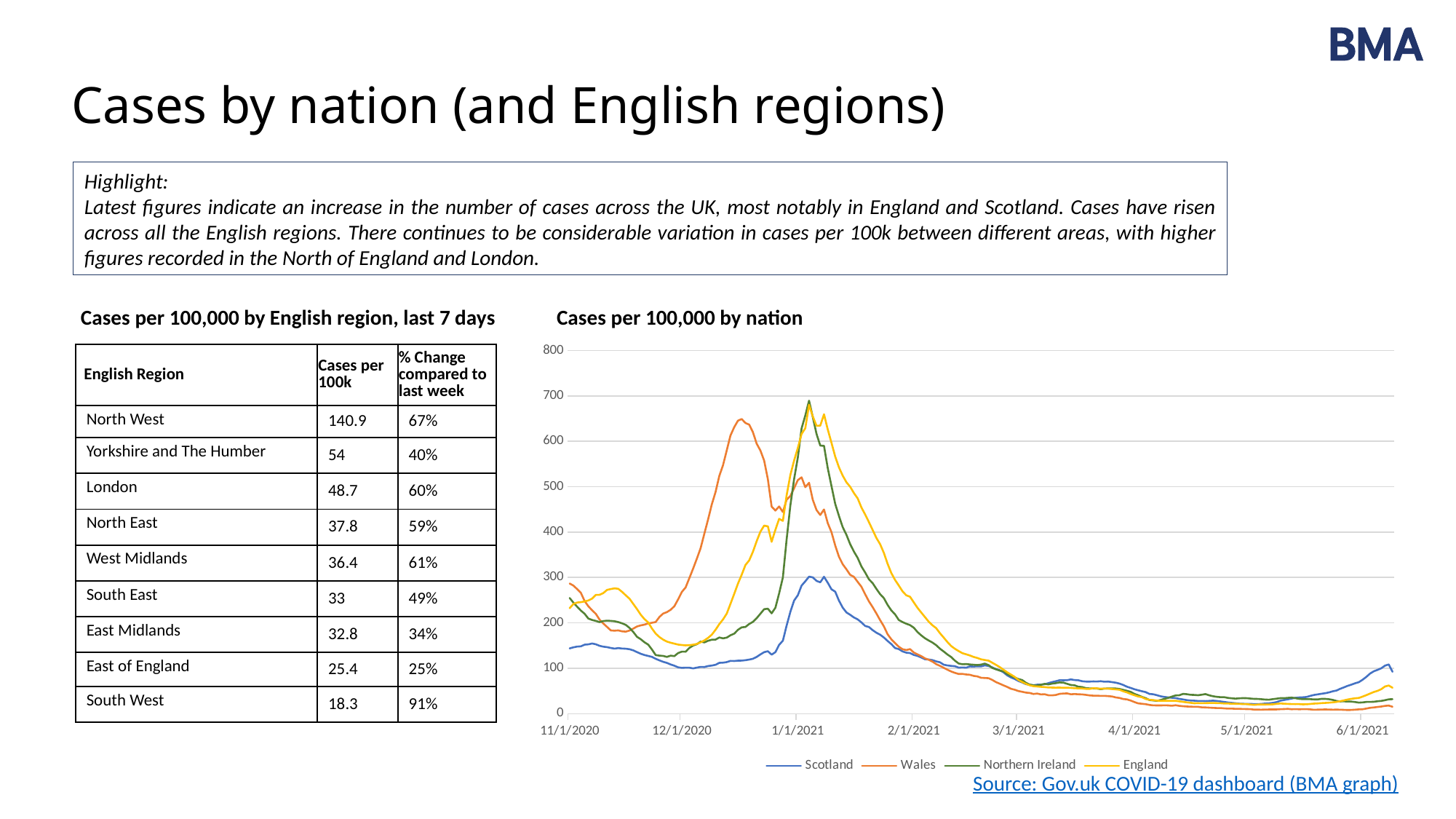
What kind of chart is 'Cases per 100,000 by nation'? line chart In the 'Cases per 100,000 by nation' chart, at 6/1/2021 which is higher, Scotland or Wales? Scotland In the 'Cases per 100,000 by nation' chart, is the peak value for Wales greater or less than 600? greater In the 'Cases per 100,000 by nation' chart, which nation's line reached the lowest peak? Scotland How many date labels are shown on the x axis of the 'Cases per 100,000 by nation' chart? 8 How many series does the legend of the 'Cases per 100,000 by nation' chart list? 4 Which nations are listed in the legend of the 'Cases per 100,000 by nation' chart? Scotland, Wales, Northern Ireland, England In the 'Cases per 100,000 by nation' chart, is the value for Wales at 6/1/2021 greater or less than 100? less In the 'Cases per 100,000 by nation' chart, do the values for all nations rise or fall between 1/1/2021 and 3/1/2021? fall In the 'Cases per 100,000 by nation' chart, which nation's line reached its peak earliest? Wales In the 'Cases per 100,000 by nation' chart, is the peak value for Northern Ireland greater or less than 600? greater